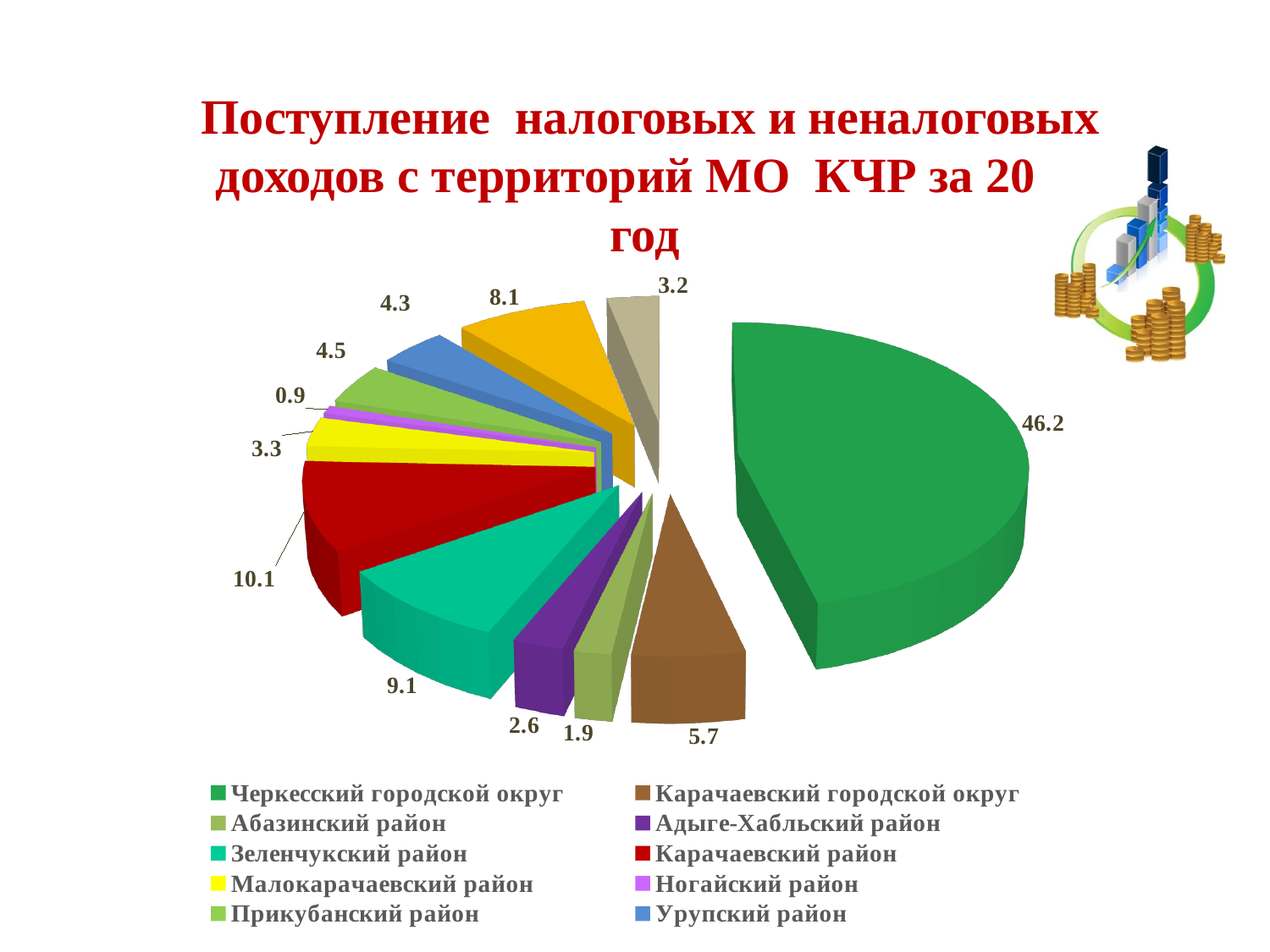
What is the value shown for Карачаевский городской округ? 5.7 Which category has the smallest slice of the pie? Ногайский район What is the difference between the values for Черкесский городской округ and Карачаевский район? 36.1 What is the value shown for Черкесский городской округ? 46.2 What is the value shown for Адыге-Хабльский район? 2.6 What is the value shown for Зеленчукский район? 9.1 How many slices does the pie chart have? 12 Which category has the largest slice of the pie? Черкесский городской округ What is the value shown for Карачаевский район? 10.1 What kind of chart is shown on the slide? Pie chart How many entries does the legend list? 10 Which is larger, the value for Прикубанский район or the value for Урупский район? Прикубанский район